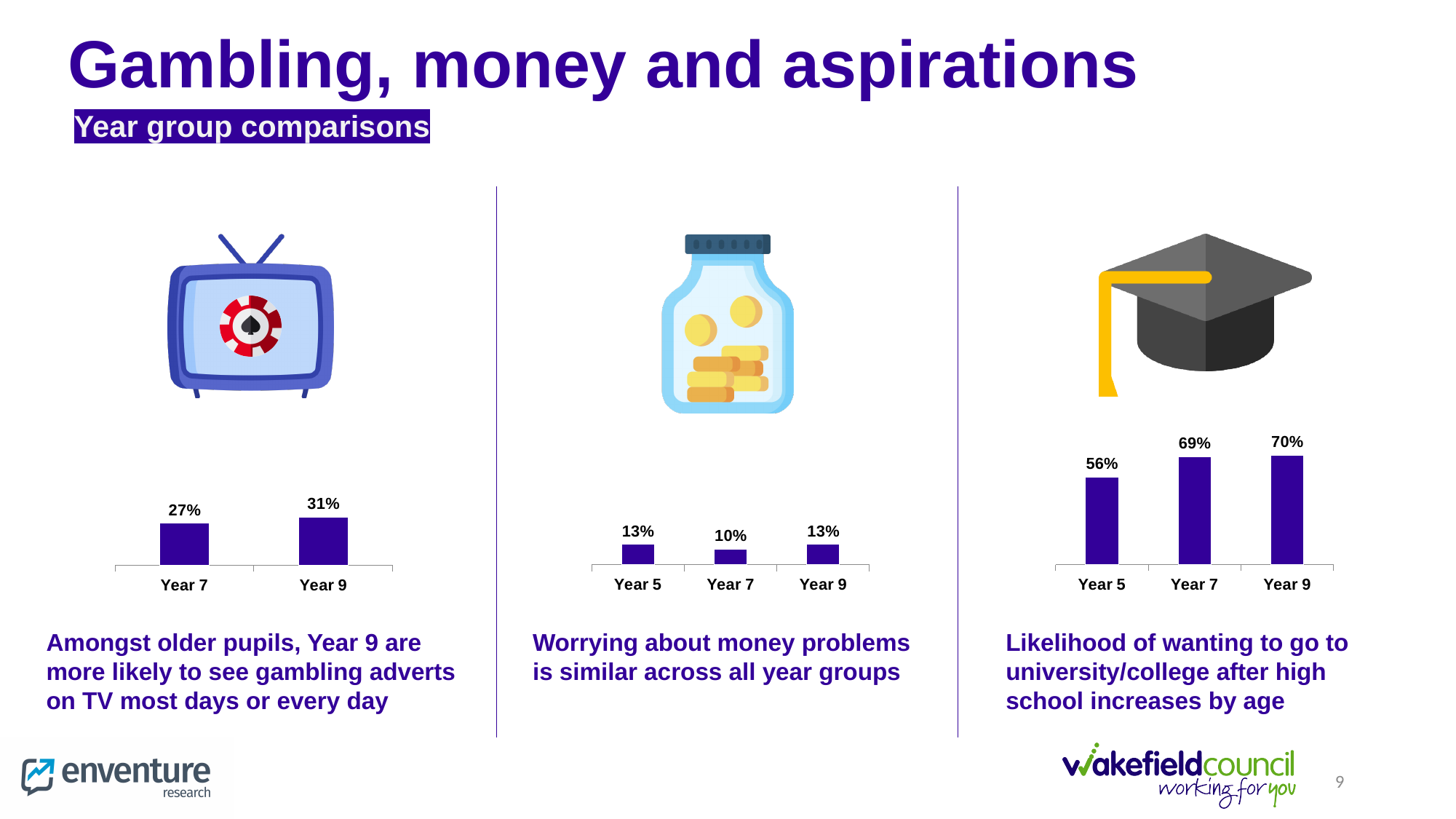
In the left chart (gambling adverts on TV), what is the value for Year 7? 27% What kind of chart is the right chart (wanting to go to university/college)? bar chart In the right chart (wanting to go to university/college), what is the value for Year 5? 56% In the left chart (gambling adverts on TV), which is larger, Year 7 or Year 9? Year 9 In the right chart (wanting to go to university/college), do the values rise or fall from Year 5 to Year 9? rise In the left chart (gambling adverts on TV), what is the difference between Year 9 and Year 7? 4% In the right chart (wanting to go to university/college), which year group has the highest value? Year 9 In the middle chart (worrying about money problems), what is the value for Year 7? 10% In the middle chart (worrying about money problems), how many year groups are shown? 3 In the middle chart (worrying about money problems), which year group has the lowest value? Year 7 In the left chart (gambling adverts on TV), what is the value for Year 9? 31% In the right chart (wanting to go to university/college), what is the difference between Year 9 and Year 5? 14%